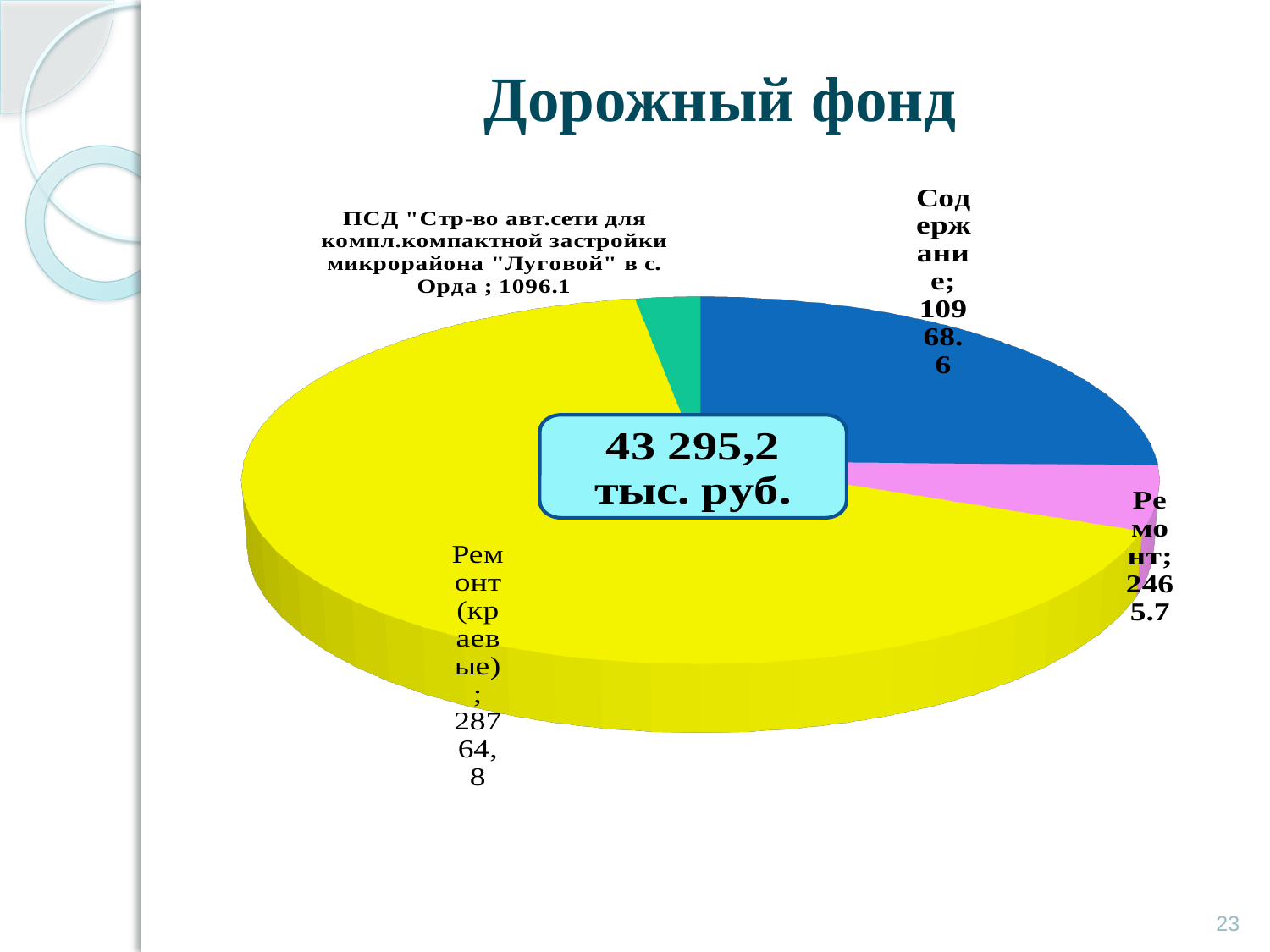
What is the value for Содержание? 10968.6 Which category has the largest slice of the pie? Ремонт (краевые) What is the value for Ремонт (краевые)? 28764,8 What is the value for Ремонт? 2465.7 What is the title of the slide with the chart? Дорожный фонд How many slices does the pie chart have? 4 What is the difference between the values for Содержание and Ремонт? 8502.9 What kind of chart is shown on the slide? Pie chart Which is larger, Содержание or Ремонт? Содержание What total amount is shown in the box in the centre of the pie chart? 43 295,2 тыс. руб. What is the value for the ПСД "Стр-во авт.сети для компл.компактной застройки микрорайона "Луговой" в с. Орда" slice? 1096.1 Which category has the smallest slice of the pie? ПСД "Стр-во авт.сети для компл.компактной застройки микрорайона "Луговой" в с. Орда"